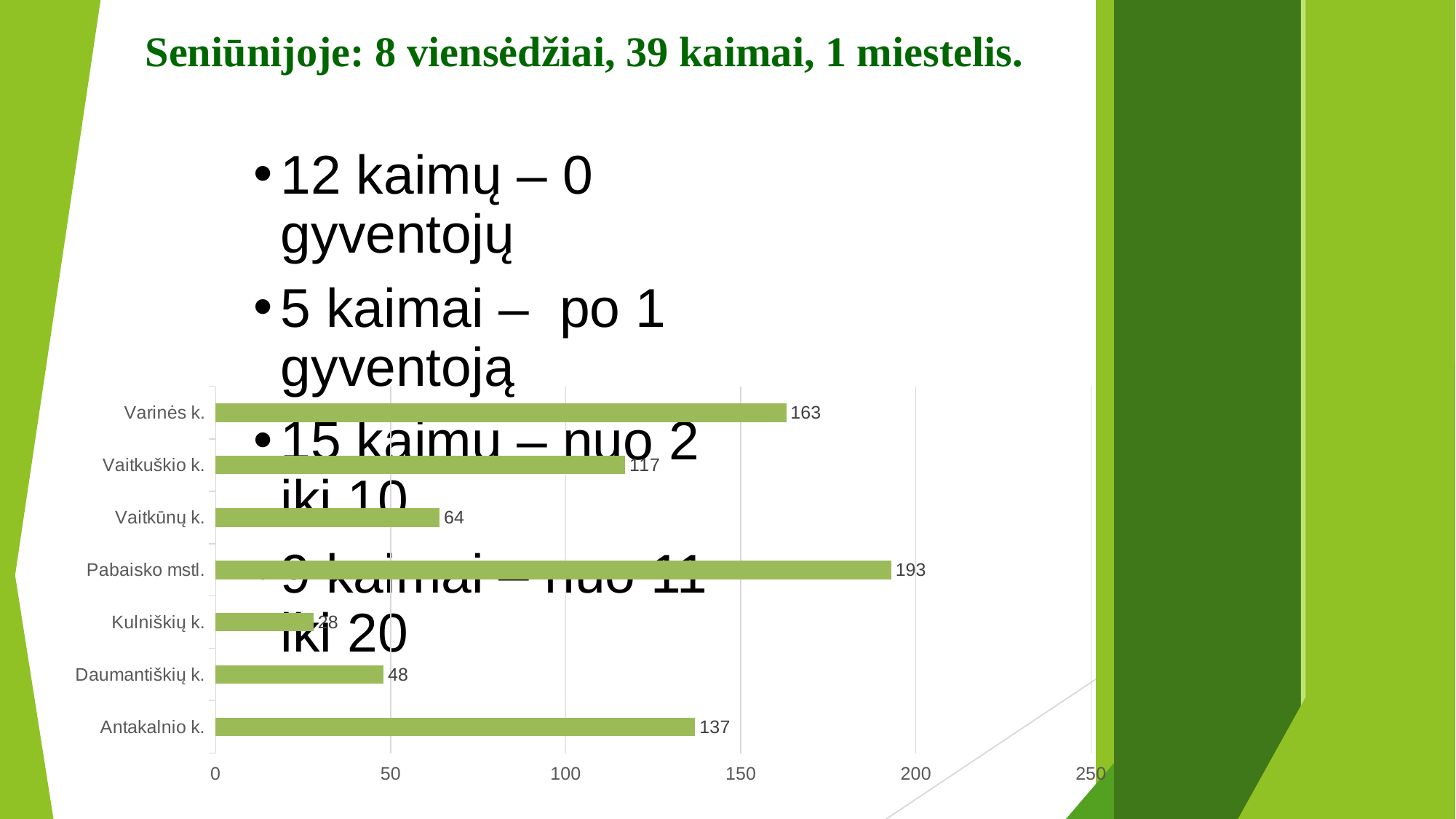
Which category has the lowest value? Kulniškių k. What is the value for Varinės k.? 163 Which category has the highest value? Pabaisko mstl. What is the value for Antakalnio k.? 137 What is the value for Daumantiškių k.? 48 What is the difference between the values for Antakalnio k. and Daumantiškių k.? 89 Is the value for Kulniškių k. greater or less than 50? less What is the value for Pabaisko mstl.? 193 Which is larger, the value for Vaitkuškio k. or the value for Antakalnio k.? Antakalnio k. What is the difference between the values for Pabaisko mstl. and Varinės k.? 30 How many categories are shown in the chart? 7 What is the value for Vaitkūnų k.? 64